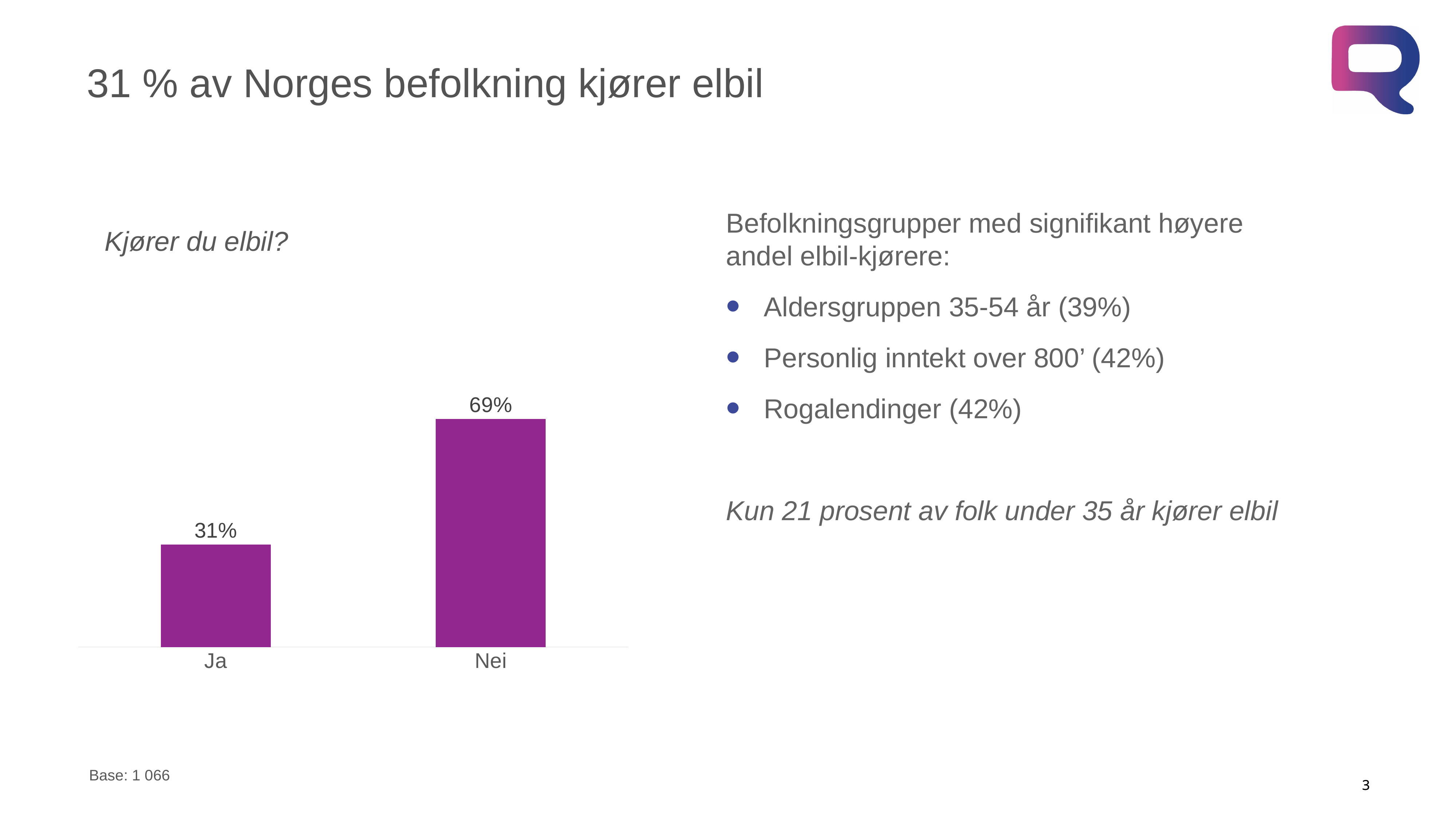
Which is larger, the value for Ja or the value for Nei? Nei What kind of chart is shown on the slide? Bar chart What is the value for Ja? 31% What is the value for Nei? 69% How many categories are shown in the chart? 2 Which category has the highest value? Nei What is the total of the values for Ja and Nei? 100% What colour are the bars in the chart? Purple Which category has the lowest value? Ja What question does the chart title ask? Kjører du elbil? What is the difference between the values for Nei and Ja? 38%